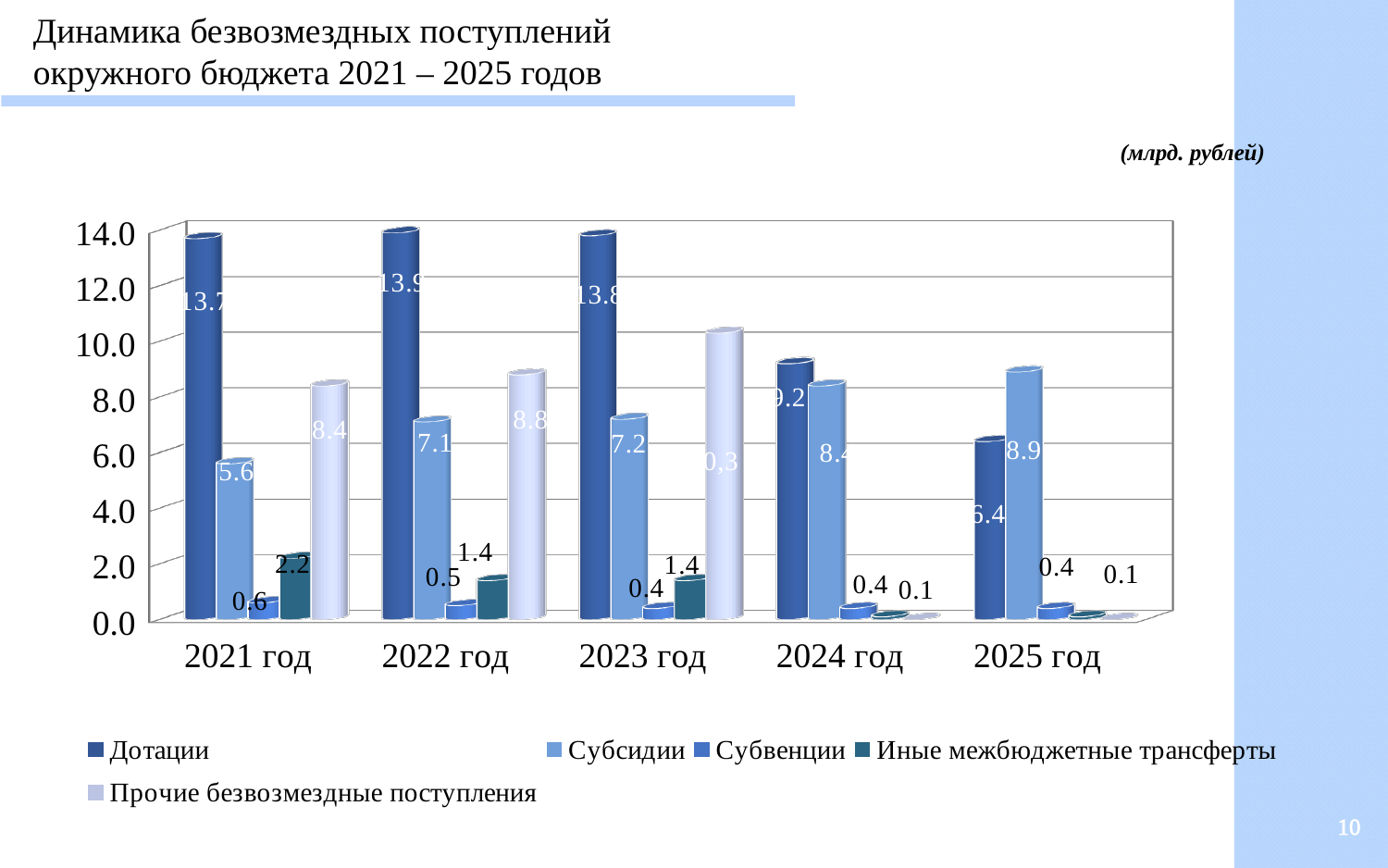
How many years are shown on the x axis? 5 In 2025 год, which is larger: Дотации or Субсидии? Субсидии What is the value of Дотации for 2021 год? 13.7 How many series does the legend list? 5 What is the difference between Дотации and Субсидии in 2021 год? 8.1 Is the value of Прочие безвозмездные поступления for 2023 год greater or less than 10.0? greater What is the value of Субсидии for 2025 год? 8.9 What kind of chart is shown on the slide? bar chart What is the value of Иные межбюджетные трансферты for 2021 год? 2.2 In which year is the value of Дотации the lowest? 2025 год In which year is the value of Дотации the highest? 2022 год Do the values of Дотации rise or fall from 2023 год to 2025 год? fall